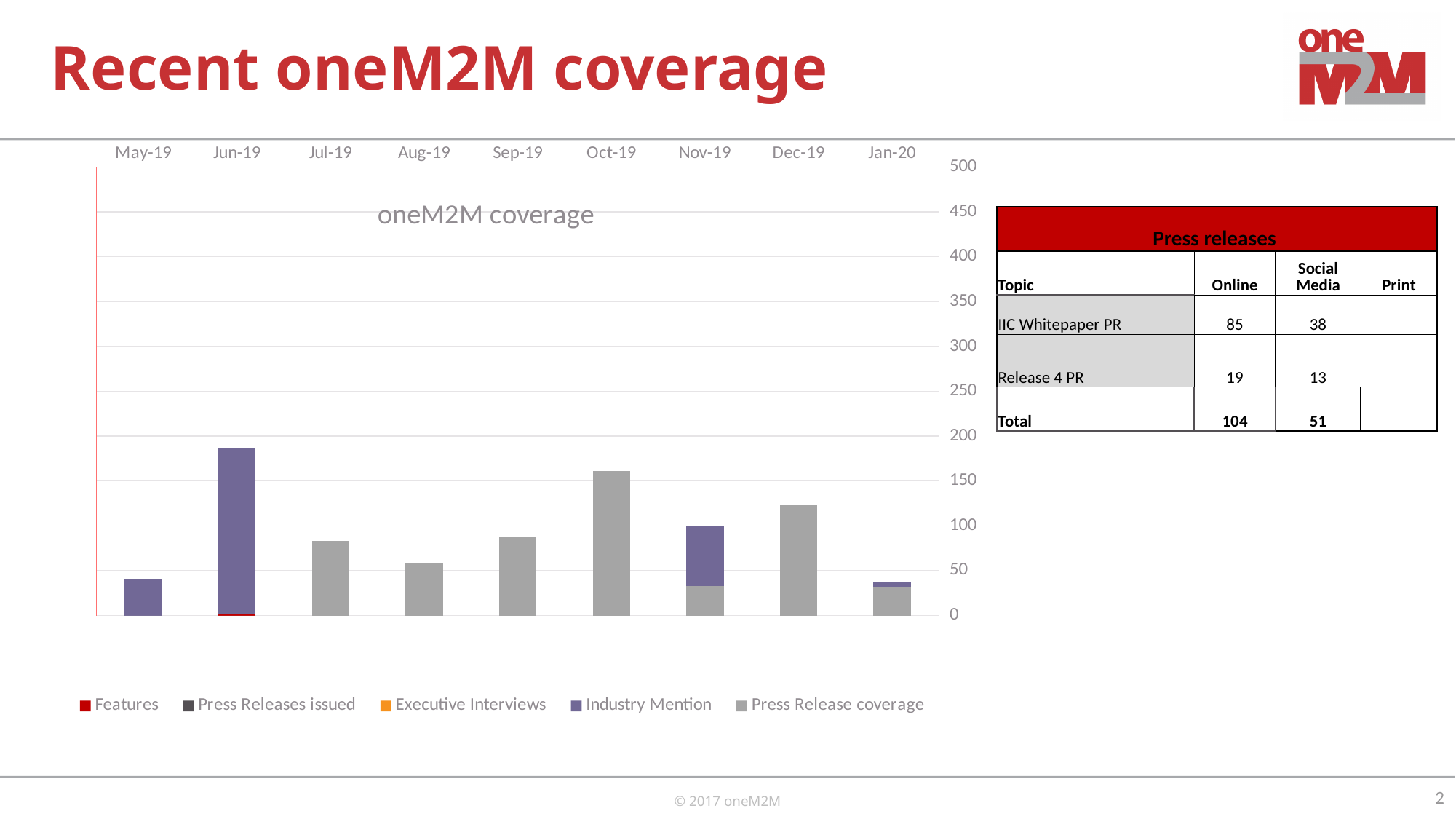
Is the total bar for Jun-19 greater or less than 150? greater What kind of chart is shown on the slide? bar chart Which bar is taller, Jun-19 or Oct-19? Jun-19 Is the bar for Dec-19 greater or less than 100? greater Is the bar for Oct-19 greater or less than 100? greater Which bar is taller, Oct-19 or Dec-19? Oct-19 How many months are shown along the x axis of the chart? 9 How many series does the chart legend list? 5 What is the title of the chart? oneM2M coverage Which series makes up almost all of the Jun-19 bar? Industry Mention Which month has the tallest bar in the chart? Jun-19